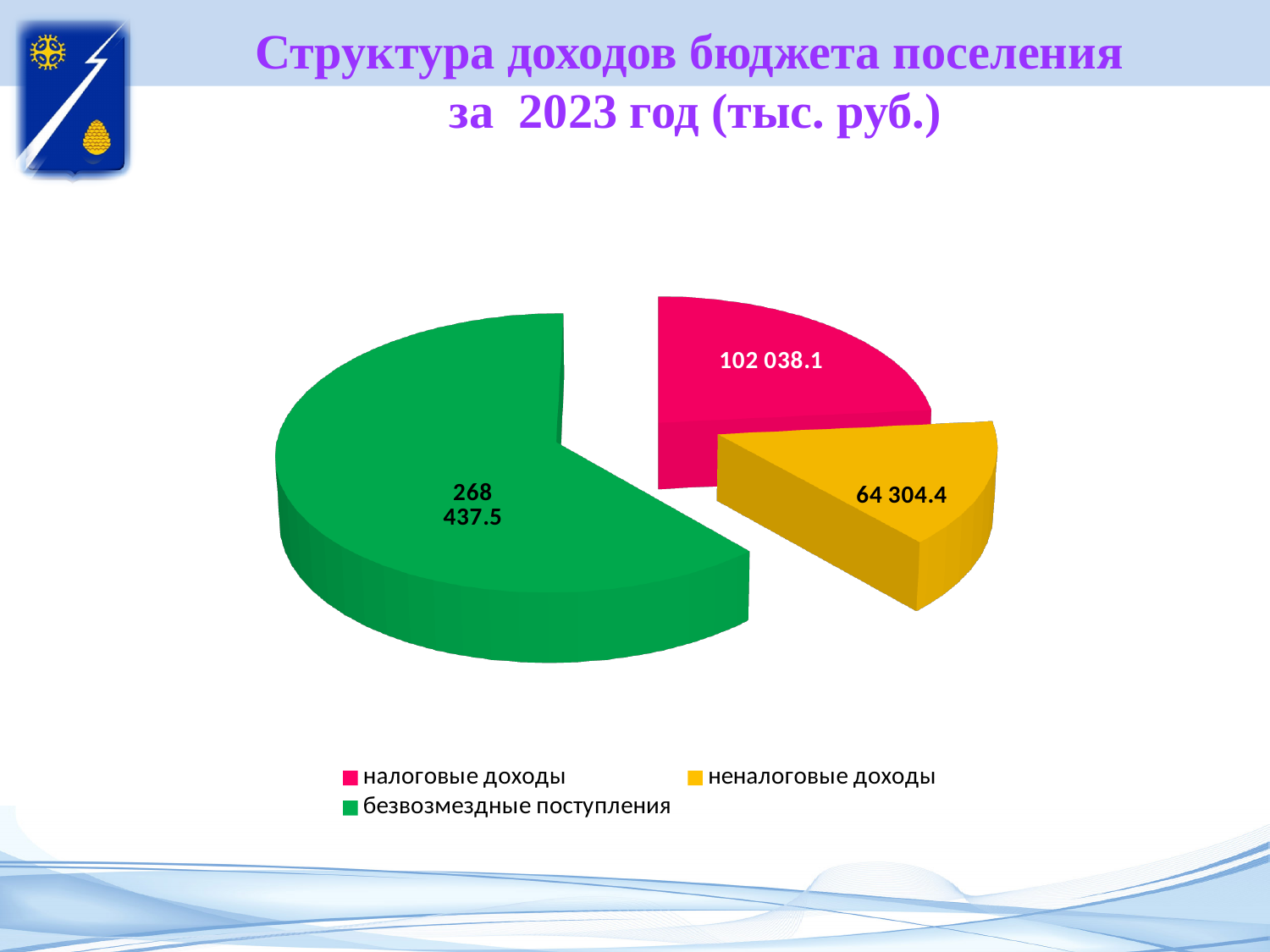
What is the difference between безвозмездные поступления and налоговые доходы? 166 399.4 What is the value for налоговые доходы? 102 038.1 What is the value for безвозмездные поступления? 268 437.5 Which category has the largest slice of the pie? безвозмездные поступления What is the difference between налоговые доходы and неналоговые доходы? 37 733.7 Which is larger, налоговые доходы or неналоговые доходы? налоговые доходы What colour is the slice for безвозмездные поступления? green How many slices does the pie chart have? 3 What is the title of the chart on the slide? Структура доходов бюджета поселения за 2023 год (тыс. руб.) Which category has the smallest slice of the pie? неналоговые доходы What is the value for неналоговые доходы? 64 304.4 What type of chart is shown on the slide? pie chart